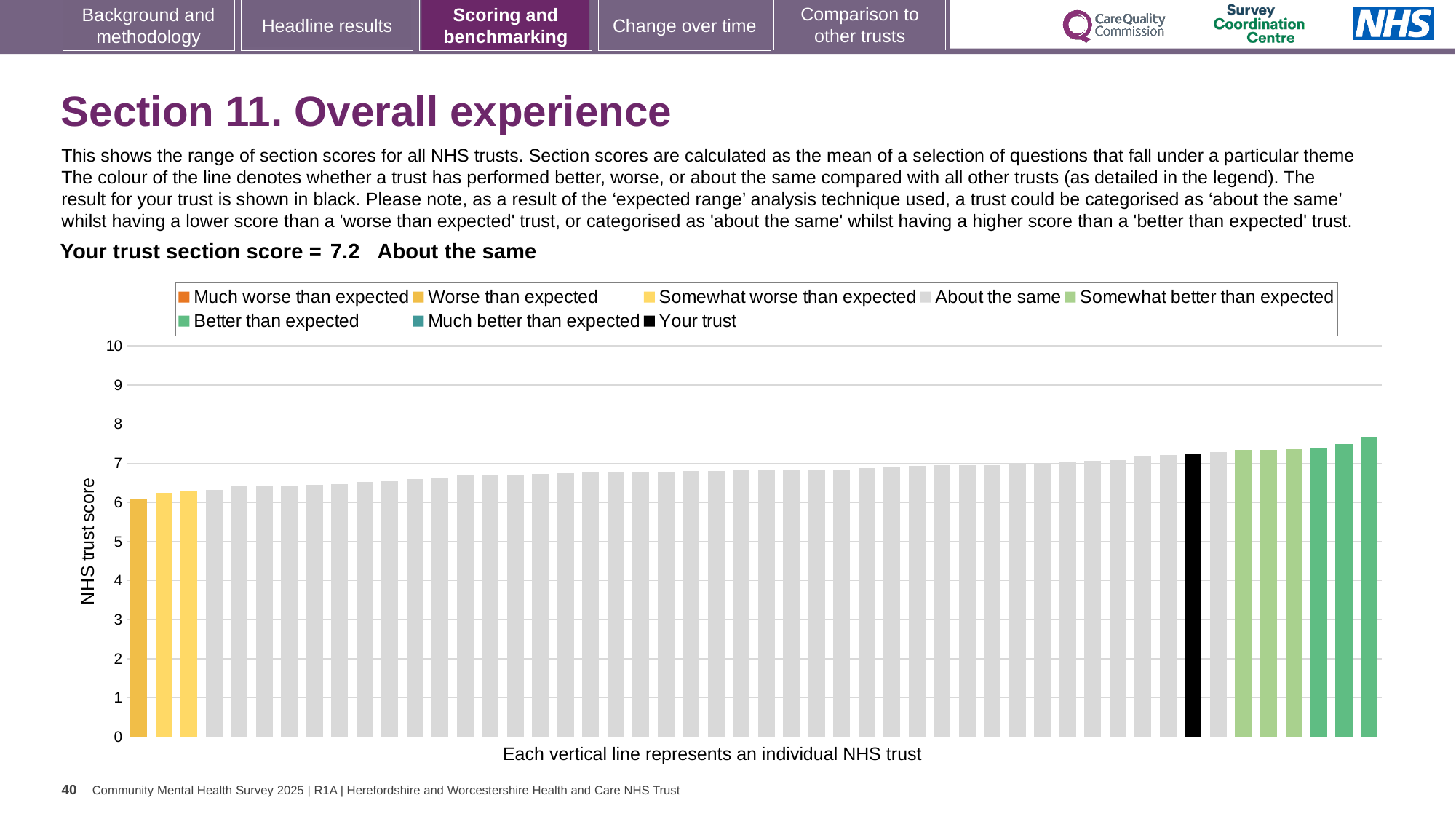
Which category is your trust placed in for this section? About the same How many bars are shaded yellow (worse or somewhat worse than expected)? 3 What is the label of the vertical axis? NHS trust score Is the value of the leftmost bar greater or less than 7? less Is the value of the black bar (your trust) greater or less than 7? greater What kind of chart is shown on the slide? bar chart How many entries does the chart legend list? 8 What is the maximum value shown on the vertical axis? 10 Is the black bar for your trust taller or shorter than the rightmost bar? shorter Is the value of the tallest bar greater or less than 8? less Do the bar values rise or fall from left to right across the chart? rise What is the section score for your trust shown on the slide? 7.2